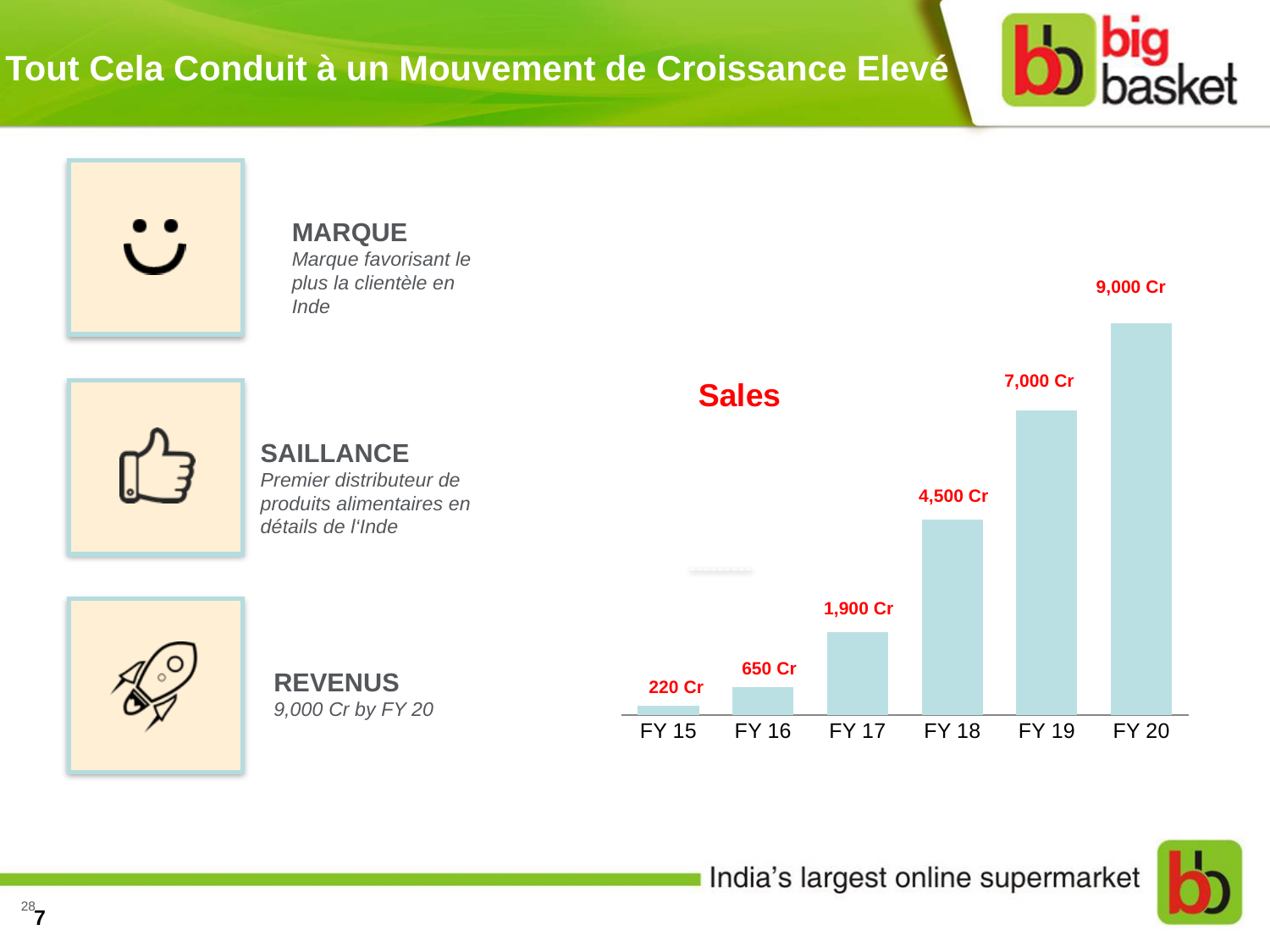
What is the Sales value for FY 15? 220 Cr How many fiscal years are shown on the Sales chart? 6 Which fiscal year has the lowest Sales? FY 15 What is the title of the chart? Sales What is the difference in Sales between FY 20 and FY 19? 2,000 Cr What is the Sales value for FY 17? 1,900 Cr What is the difference in Sales between FY 16 and FY 15? 430 Cr What is the Sales value for FY 18? 4,500 Cr What kind of chart is the Sales chart? Bar chart Which has higher Sales, FY 17 or FY 18? FY 18 Do Sales rise or fall from FY 15 to FY 20? Rise Which fiscal year has the highest Sales? FY 20